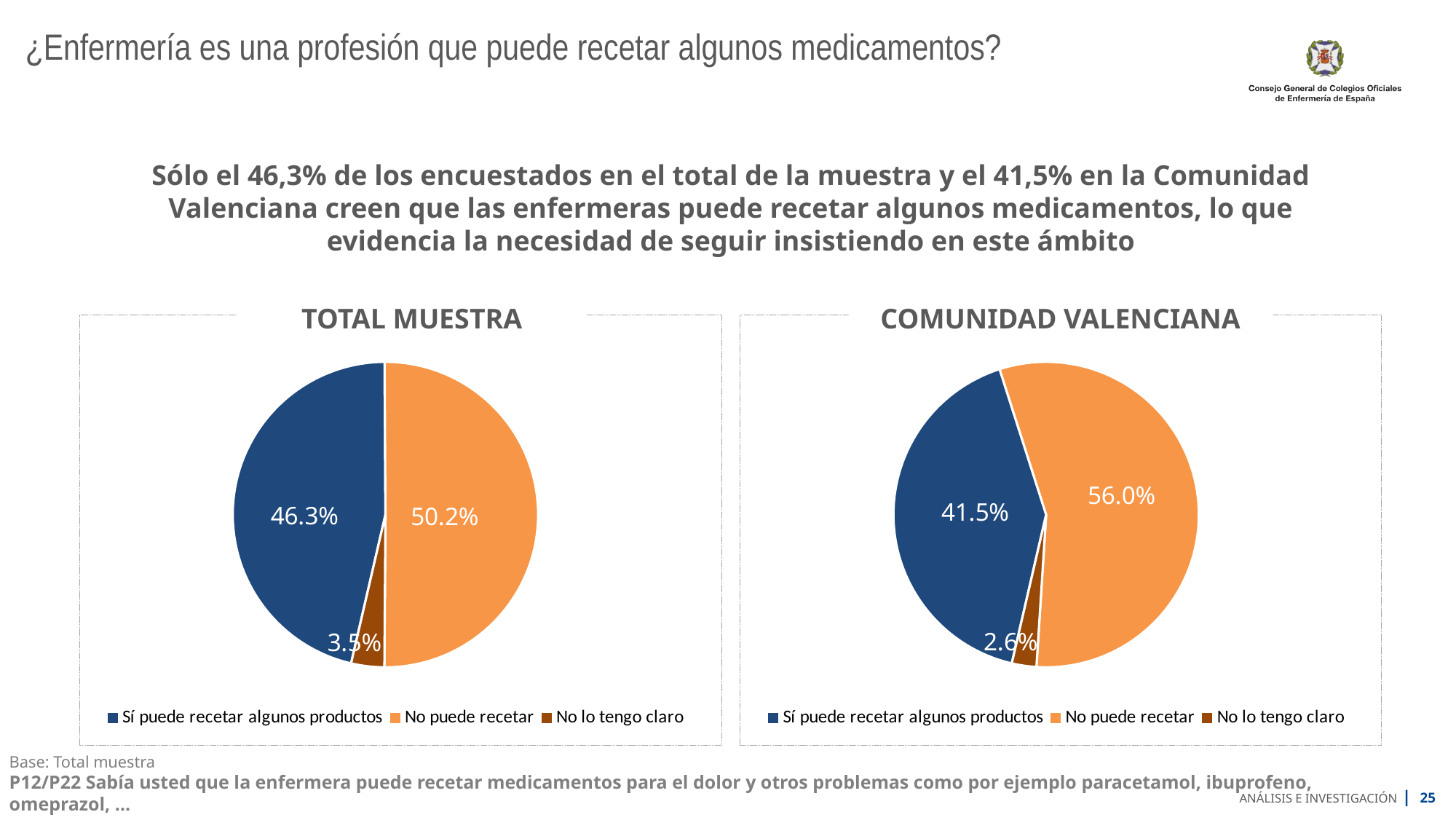
Which chart has the larger share for 'Sí puede recetar algunos productos', TOTAL MUESTRA or COMUNIDAD VALENCIANA? TOTAL MUESTRA In the COMUNIDAD VALENCIANA chart, what is the difference in percentage points between 'No puede recetar' and 'Sí puede recetar algunos productos'? 14.5 In the COMUNIDAD VALENCIANA chart, what share of respondents answered 'No lo tengo claro'? 2.6% In the COMUNIDAD VALENCIANA chart, which response has the largest slice? No puede recetar In the COMUNIDAD VALENCIANA chart, what share of respondents answered 'No puede recetar'? 56.0% How many categories does the legend of the COMUNIDAD VALENCIANA chart list? 3 In the TOTAL MUESTRA chart, what share of respondents answered 'Sí puede recetar algunos productos'? 46.3% In the COMUNIDAD VALENCIANA chart, what share of respondents answered 'Sí puede recetar algunos productos'? 41.5% In the TOTAL MUESTRA chart, what share of respondents answered 'No puede recetar'? 50.2% In the TOTAL MUESTRA chart, which response has the smallest slice? No lo tengo claro In the TOTAL MUESTRA chart, what share of respondents answered 'No lo tengo claro'? 3.5% What type of chart is used for TOTAL MUESTRA? Pie chart